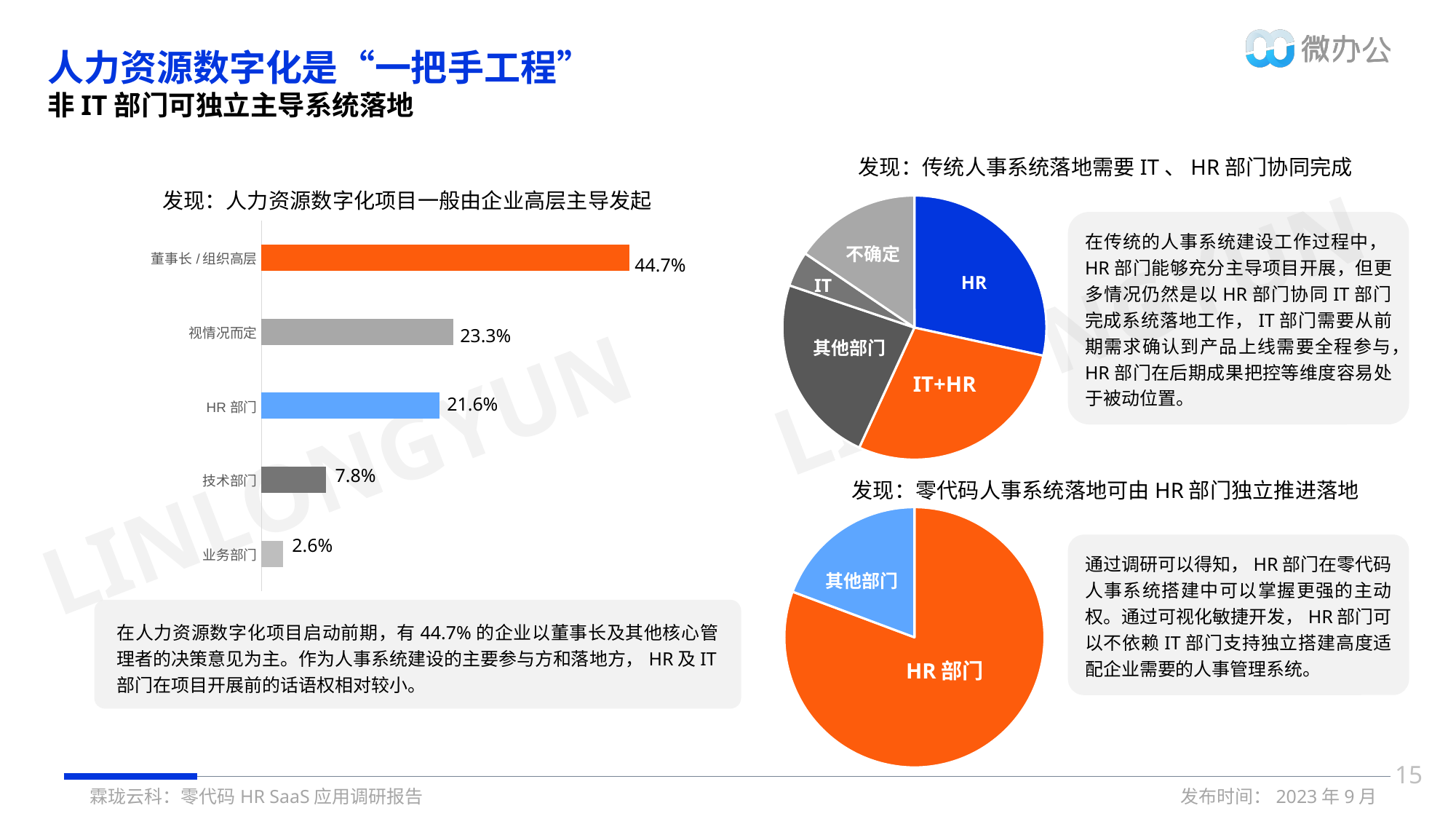
In the bar chart on the left, what is the difference between the values for 视情况而定 and HR 部门? 1.7% In the bar chart on the left, which category has the highest value? 董事长 / 组织高层 In the pie chart titled 发现：零代码人事系统落地可由 HR 部门独立推进落地, which slice is larger, HR 部门 or 其他部门? HR 部门 In the bar chart on the left, which is larger, the value for 技术部门 or the value for 业务部门? 技术部门 What kind of chart is the chart on the left of the slide? Bar chart How many slices does the pie chart titled 发现：传统人事系统落地需要 IT 、 HR 部门协同完成 have? 5 In the pie chart titled 发现：传统人事系统落地需要 IT 、 HR 部门协同完成, which slice is the smallest? IT In the bar chart on the left, what is the value for HR 部门? 21.6% In the bar chart on the left, what is the value for 技术部门? 7.8% How many categories are shown in the bar chart on the left? 5 In the bar chart on the left, which category has the lowest value? 业务部门 In the bar chart titled 发现：人力资源数字化项目一般由企业高层主导发起, what is the value for 董事长 / 组织高层? 44.7%